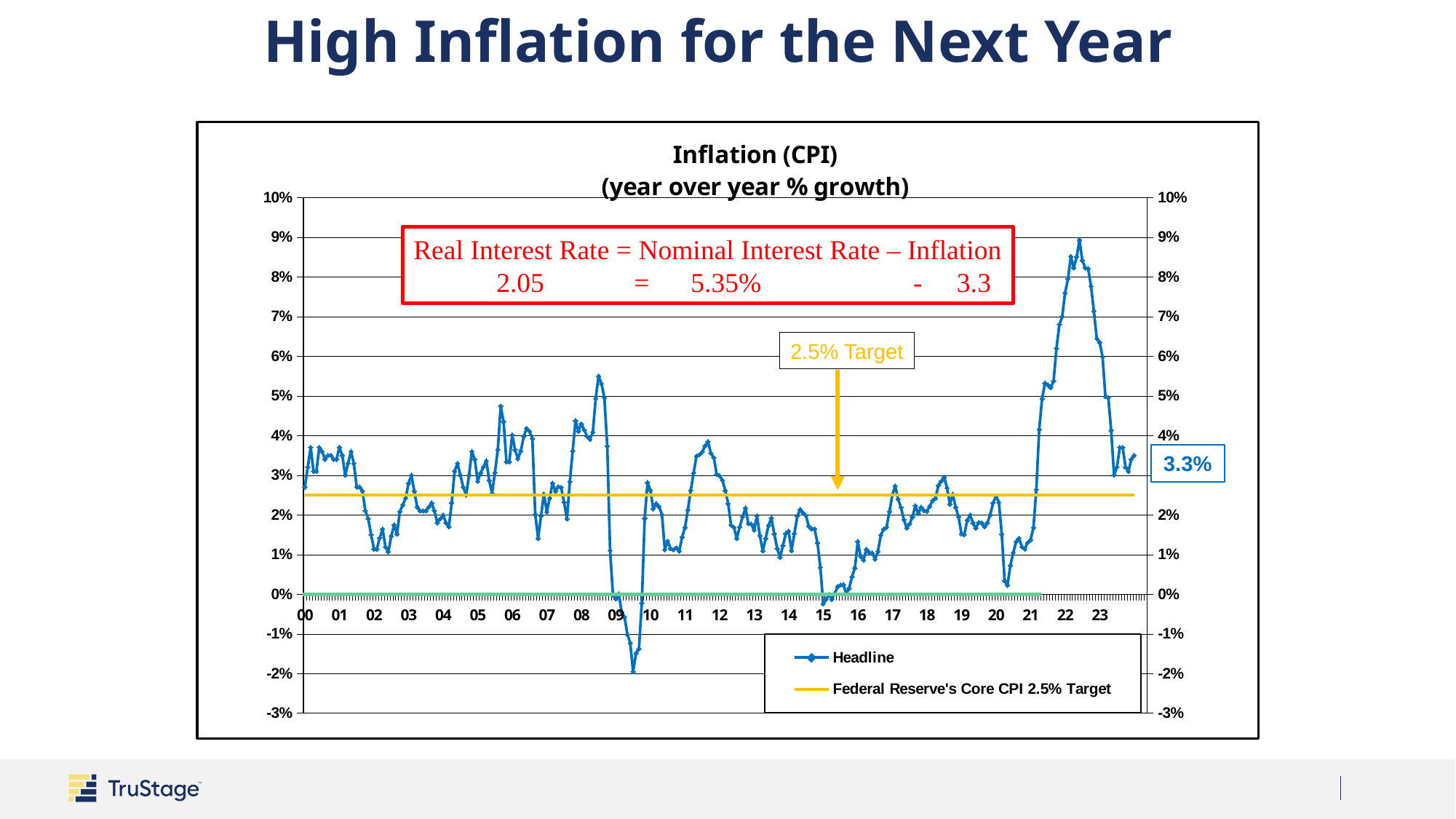
What kind of chart is shown on the slide? Line chart What is the title of the chart? Inflation (CPI) (year over year % growth) Does Headline inflation rise or fall from its 2022 peak into 2023? Fall What value does the Federal Reserve's Core CPI target line sit at? 2.5% What is the most recent Headline inflation value labeled on the chart? 3.3% How many series does the chart legend list? 2 Is the lowest Headline inflation value in 2009 greater or less than -1%? less Which is larger: the Headline inflation peak in 2022 or the peak in 2008? 2022 In which year does Headline inflation reach its lowest point on the chart? 09 Is the peak Headline inflation value in 2022 greater or less than 8%? greater Is the latest Headline inflation value of 3.3% greater or less than the 2.5% target? greater In which year does Headline inflation reach its highest point on the chart? 22